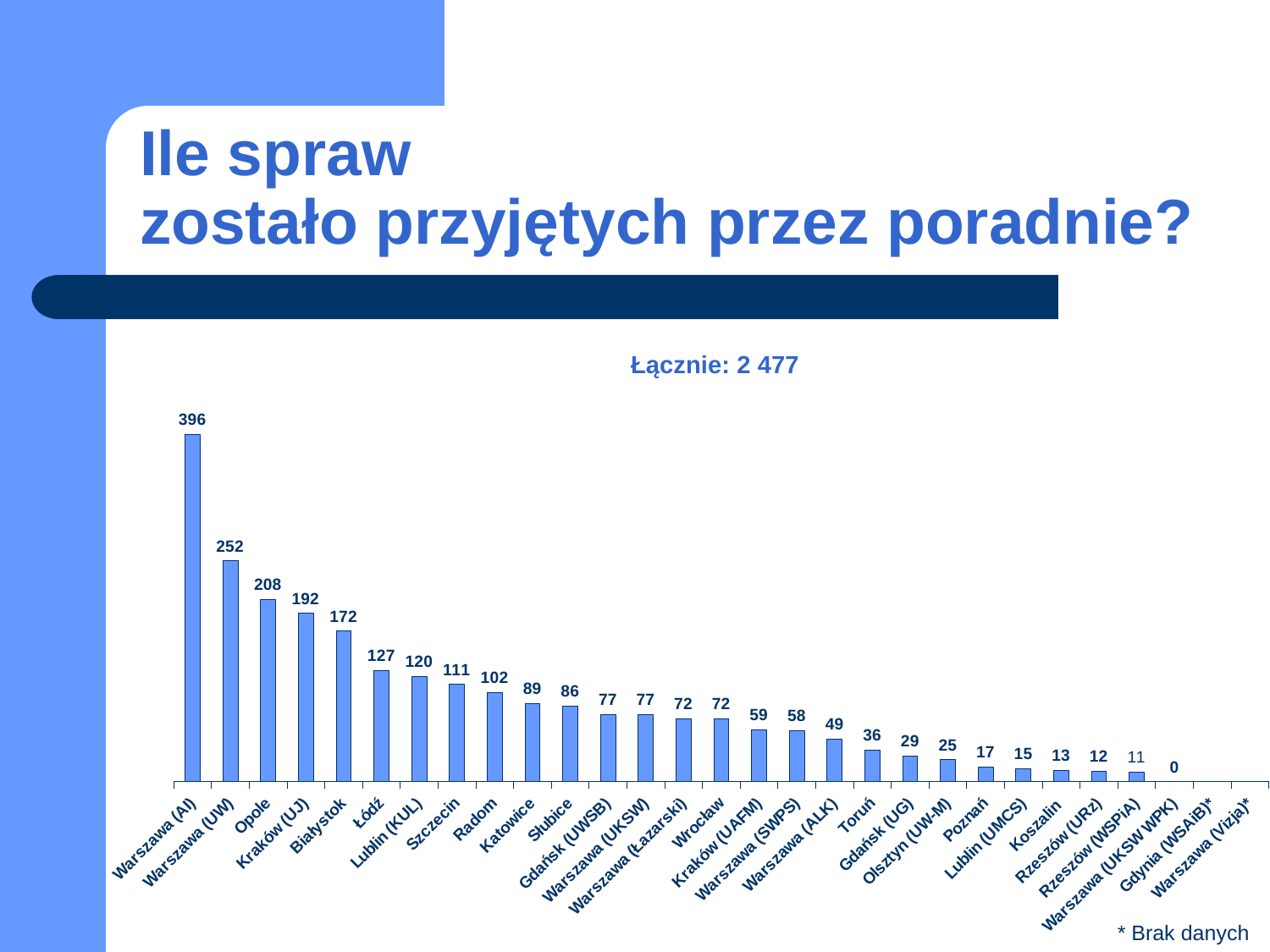
What is the value for Lublin (KUL)? 120 What is the difference between the values for Warszawa (AI) and Warszawa (UW)? 144 What is the value for Toruń? 36 What does the asterisk next to Gdynia (WSAiB) and Warszawa (Vizja) indicate, according to the footnote? Brak danych Which category has the highest value? Warszawa (AI) What total is stated above the chart (Łącznie)? 2 477 What kind of chart is shown on the slide? bar chart Which is larger, the value for Białystok or the value for Łódź? Białystok What is the value for Opole? 208 Which category has the lowest labelled value? Warszawa (UKSW WPK) What is the value for Warszawa (AI)? 396 Do the values rise or fall from left to right along the x axis? fall